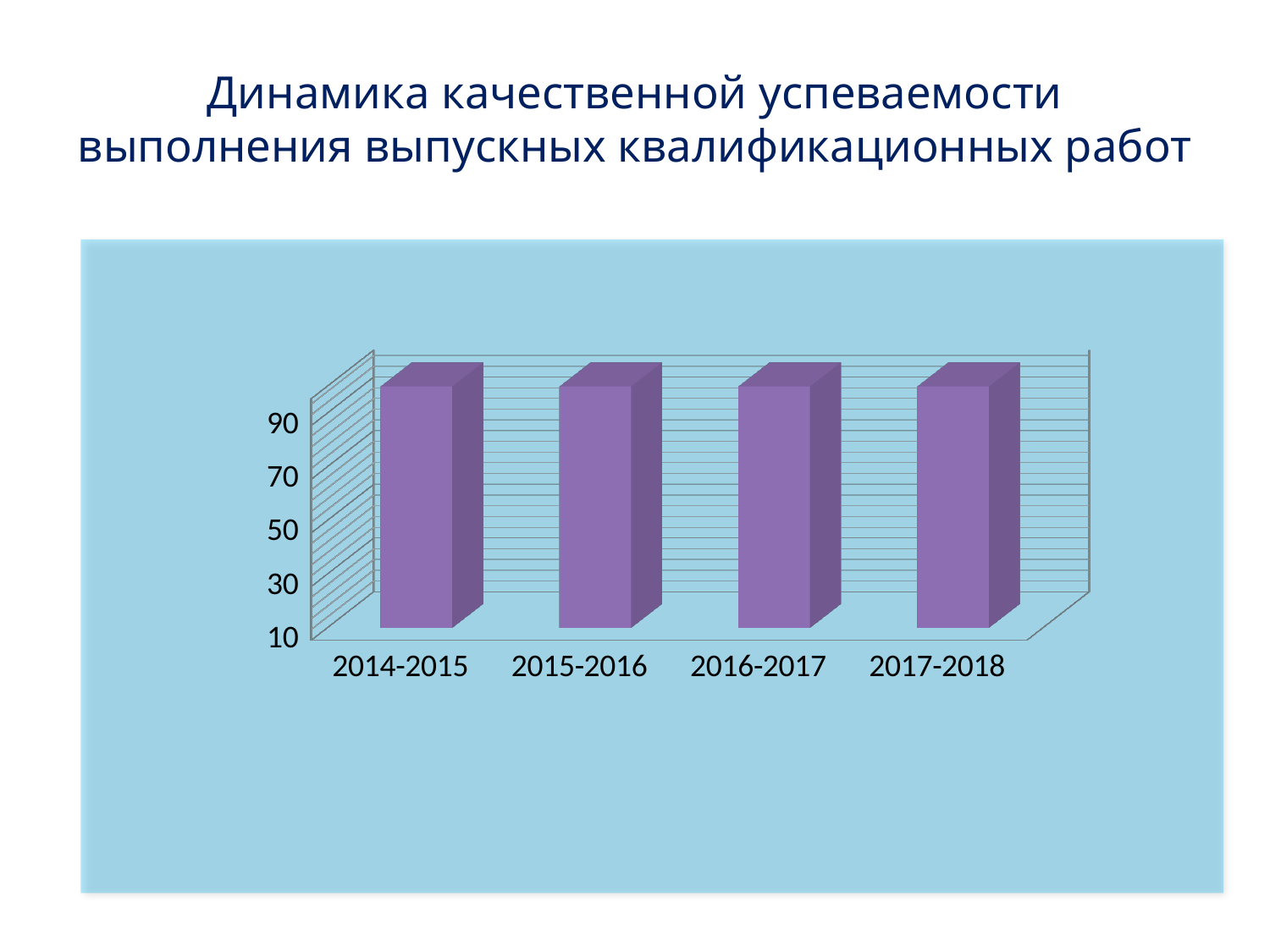
Is the value for 2014-2015 greater or less than 70? greater Do the values rise, fall, or stay roughly the same across the years on the x axis? stay roughly the same Is the value for 2015-2016 greater or less than 50? greater What is the last category on the x axis of the chart? 2017-2018 Is the value for 2017-2018 greater or less than 50? greater How many categories (academic years) are shown on the x axis of the chart? 4 What kind of chart is shown on the slide? bar chart What is the first category on the x axis of the chart? 2014-2015